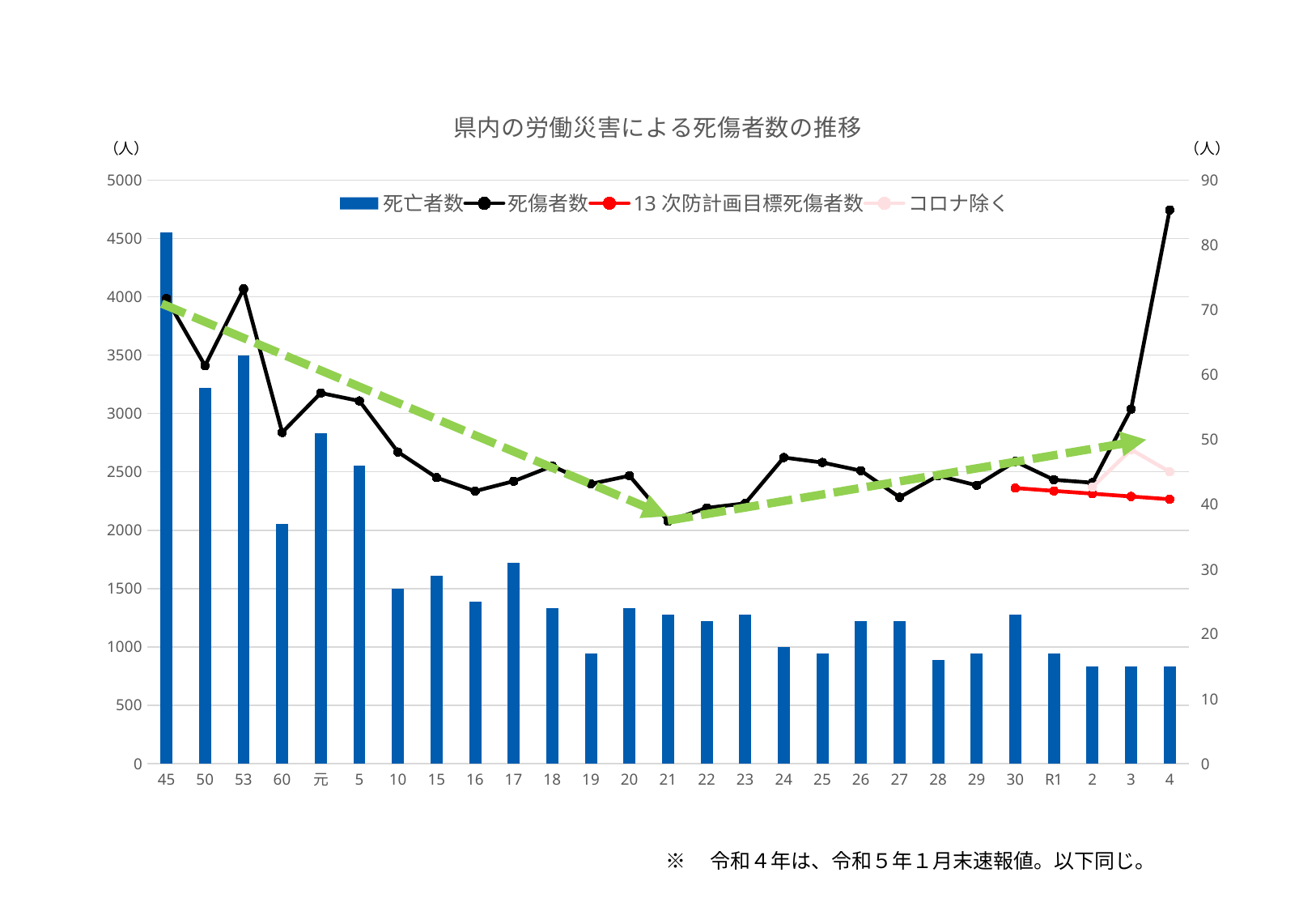
Which category has the highest 死亡者数 bar? 45 What is the title of the chart? 県内の労働災害による死傷者数の推移 Is the 死傷者数 value for 4 greater or less than 80 on the right axis? greater Do the 死亡者数 bars generally rise or fall from left to right along the x axis? fall Which category has the highest value on the 死傷者数 line? 4 What kind of chart is this? Combination bar and line chart How many series does the legend list? 4 Which category has the lowest value on the 死傷者数 line? 21 How many categories are shown on the x axis? 27 Which has the larger 死亡者数 bar, 50 or 53? 53